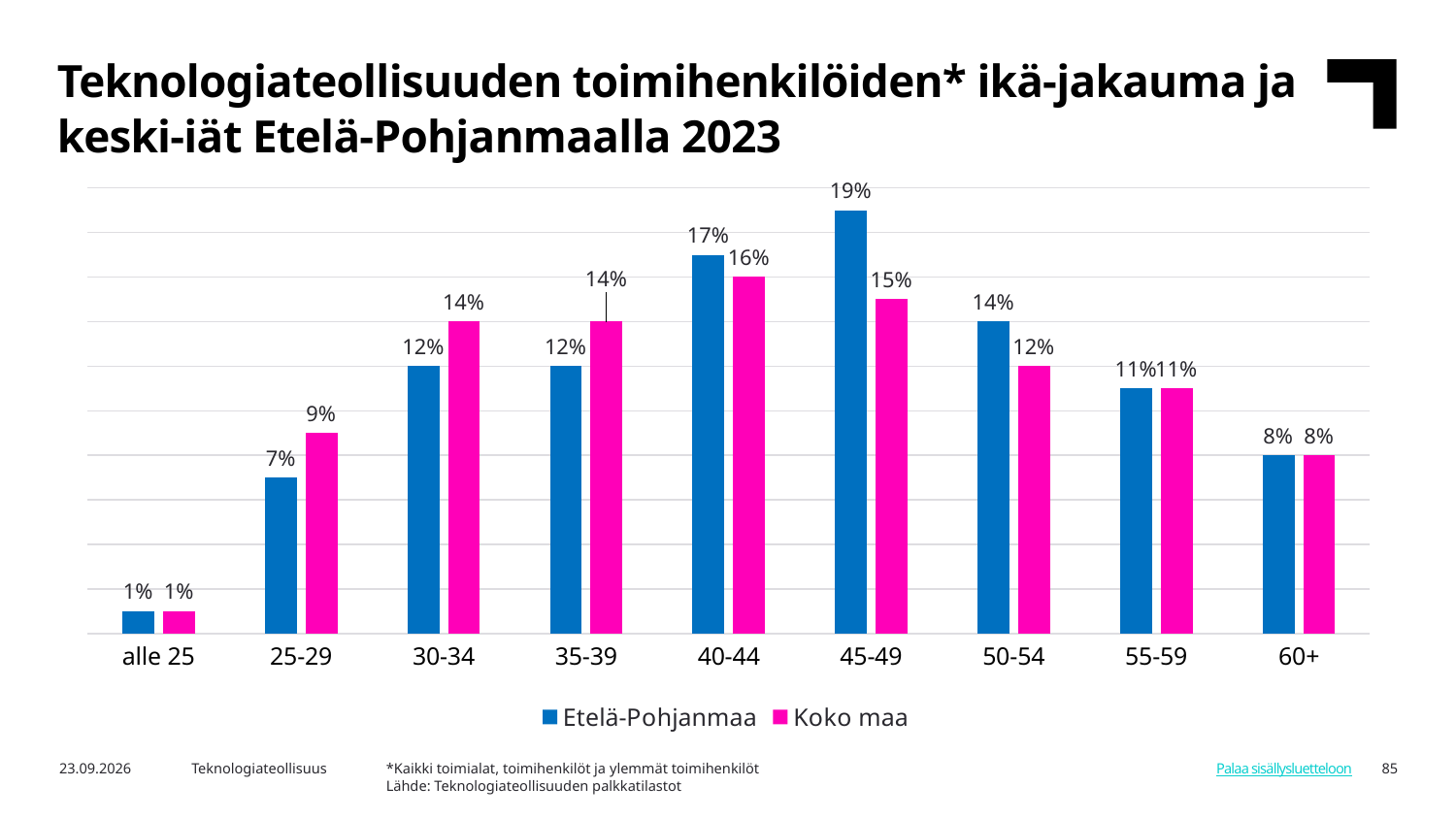
Which colour represents the Koko maa series in the chart? Pink What is the difference between Etelä-Pohjanmaa and Koko maa in the 45-49 age group? 4% What is the value for Koko maa in the 40-44 age group? 16% What is the value for Etelä-Pohjanmaa in the 45-49 age group? 19% What is the value for Koko maa in the 25-29 age group? 9% Which age group has the lowest value for Koko maa? alle 25 Do the Etelä-Pohjanmaa values rise or fall from the 45-49 age group to the 60+ age group? Fall Which age group has the highest value for Etelä-Pohjanmaa? 45-49 How many series does the legend list? 2 What kind of chart is shown on the slide? Bar chart How many age groups are shown on the x axis? 9 Which series has the larger value in the 30-34 age group, Etelä-Pohjanmaa or Koko maa? Koko maa